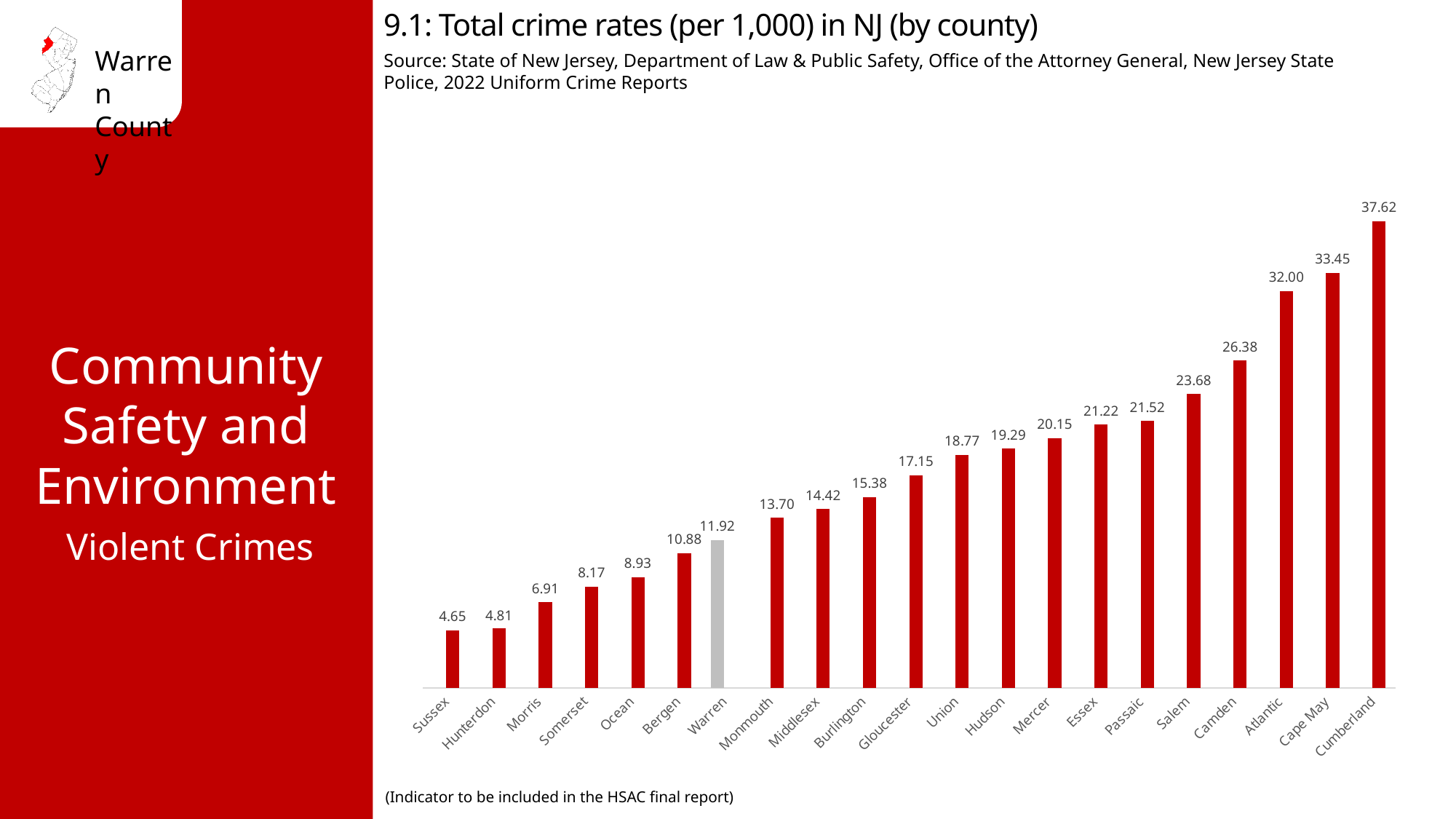
Which county's bar is coloured grey instead of red? Warren How many counties are shown in the chart? 21 Which county has the lowest total crime rate? Sussex What type of chart is shown on the slide? Bar chart What is the total crime rate for Hudson county? 19.29 What is the difference between the crime rates of Warren and Bergen? 1.04 Which county has a higher total crime rate, Camden or Salem? Camden What is the difference between the crime rates of Cumberland and Sussex? 32.97 What is the total crime rate for Cape May county? 33.45 Which county has the highest total crime rate? Cumberland What is the total crime rate for Warren county? 11.92 Do the values rise or fall from left to right along the x axis? Rise